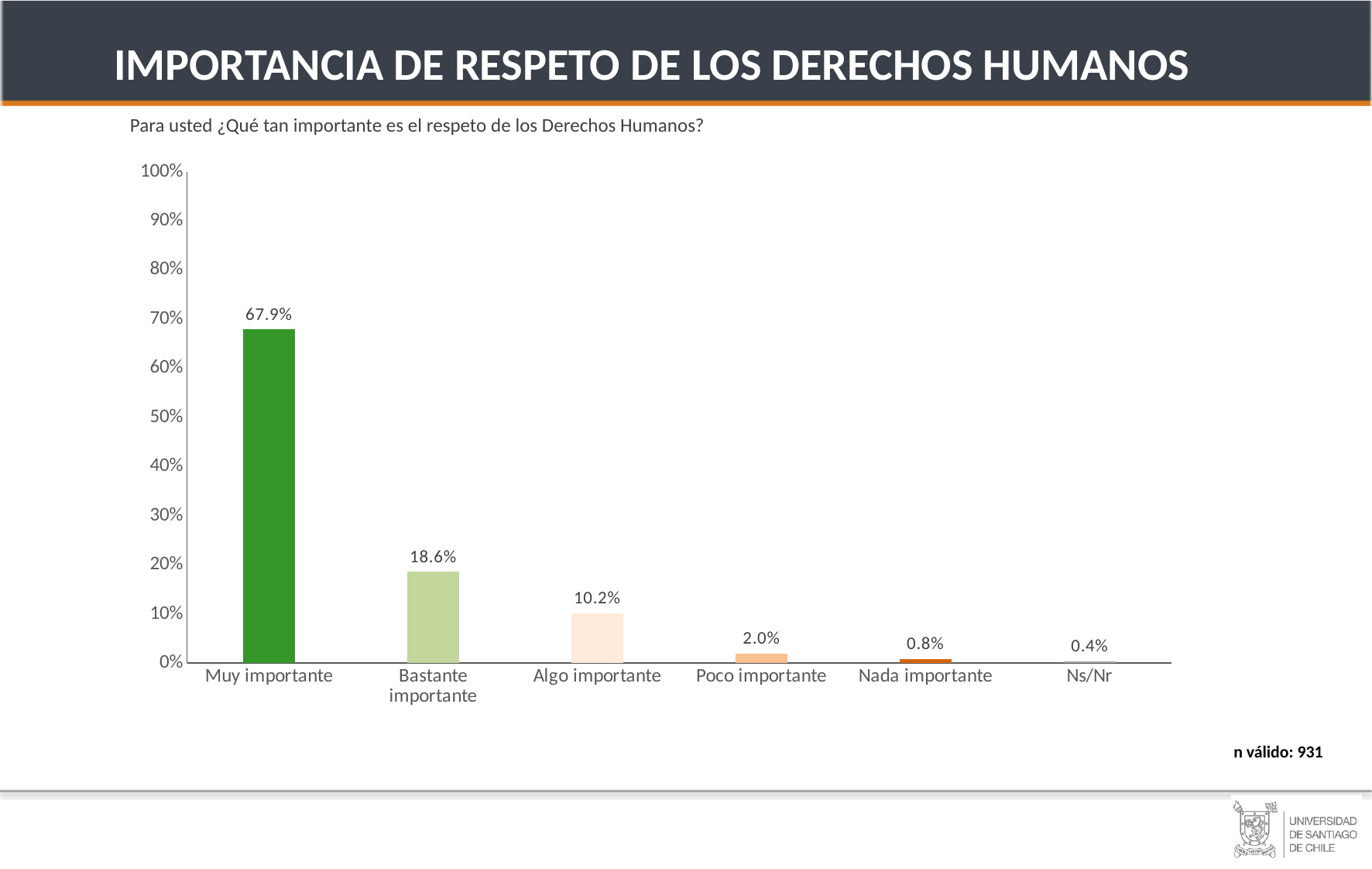
What is the value for "Bastante importante"? 18.6% Which is larger, the value for "Poco importante" or the value for "Nada importante"? Poco importante What is the value for "Algo importante"? 10.2% Which category has the lowest value? Ns/Nr What is the value for "Ns/Nr"? 0.4% What is the value for "Muy importante"? 67.9% Which category has the highest value? Muy importante How many categories are shown on the x axis? 6 Is the value for "Muy importante" greater or less than 60%? greater What is the valid sample size (n válido) shown on the slide? 931 What kind of chart is shown on the slide? bar chart What is the difference between the values for "Muy importante" and "Bastante importante"? 49.3%